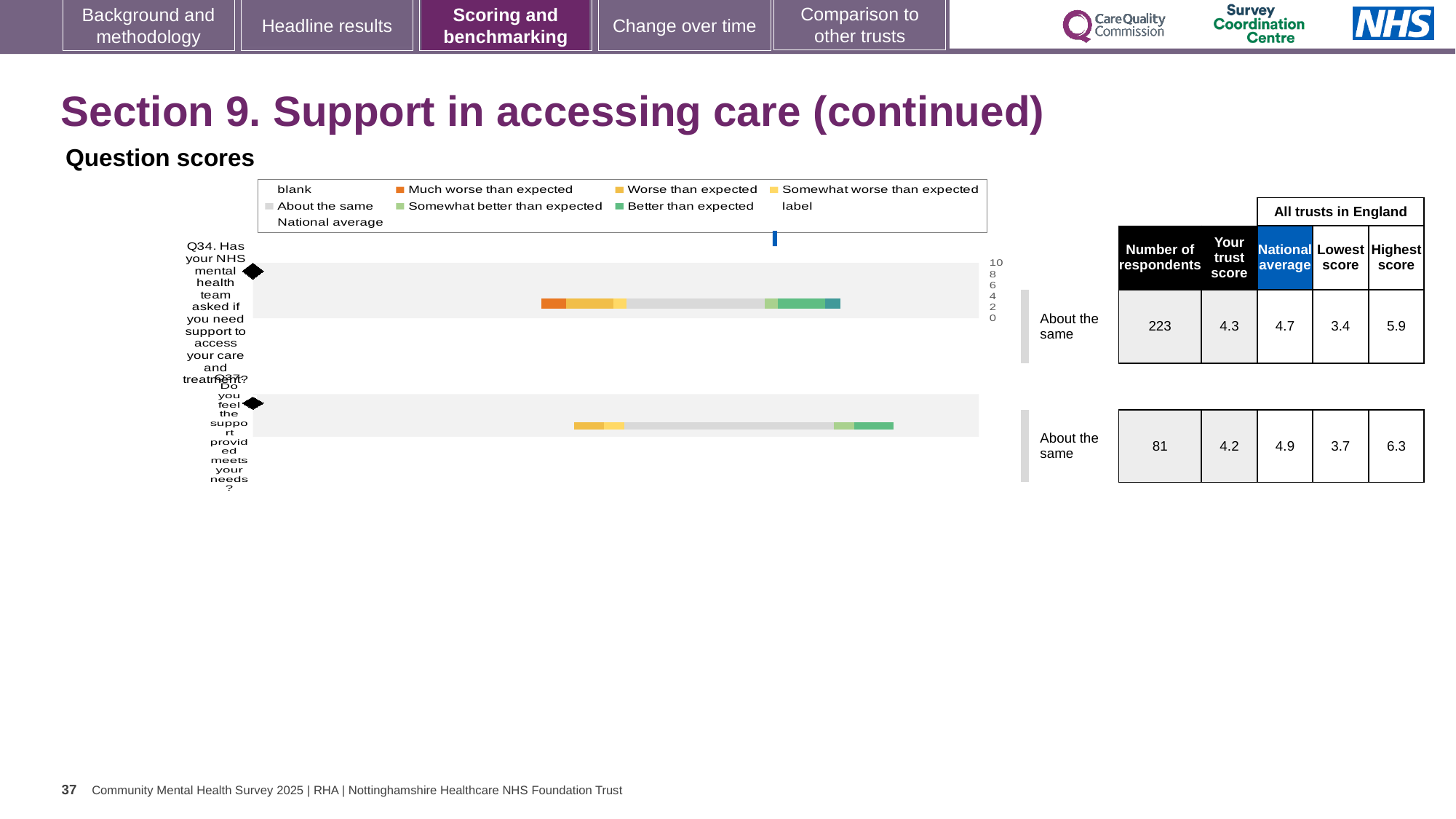
What kind of chart is used to show the question scores? bar chart How many questions are plotted in the question scores chart? 2 How many respondents answered Q34? 223 In the question scores chart legend, what colour represents 'Much worse than expected'? orange What is the national average score for Q37 (Do you feel the support provided meets your needs)? 4.9 What is the difference between the highest and lowest trust scores in England for Q34? 2.5 What is the highest score among all trusts in England for Q37? 6.3 For Q37, which is larger: the trust score or the national average? national average What is the trust score for Q34 (Has your NHS mental health team asked if you need support to access your care and treatment)? 4.3 In the question scores chart legend, what colour represents 'About the same'? grey Which question has the higher trust score, Q34 or Q37? Q34 How many respondents answered Q37? 81